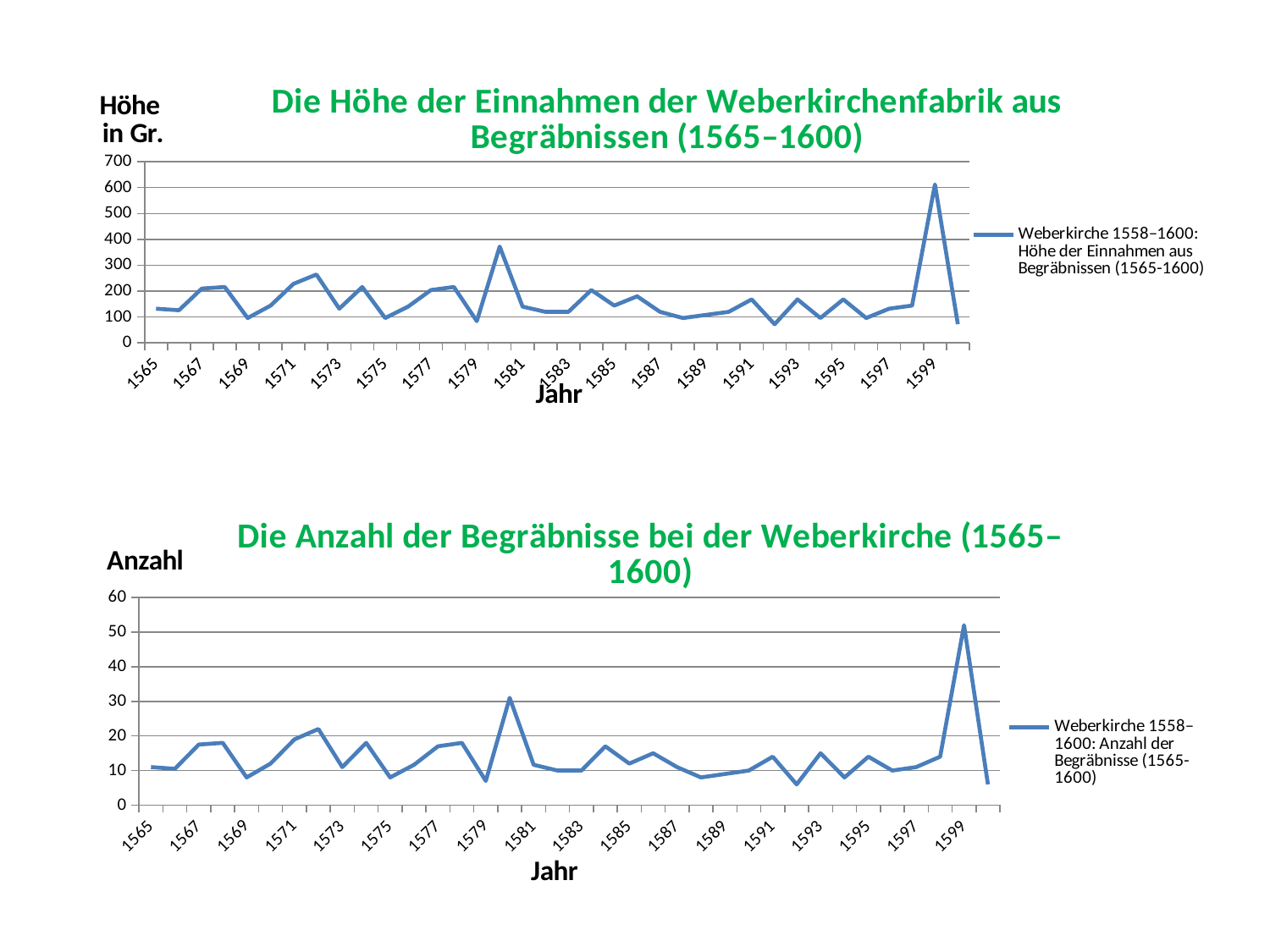
In the bottom chart (Anzahl der Begräbnisse), which year has the larger value, 1580 or 1572? 1580 In the top chart (Höhe der Einnahmen), is the value for 1580 greater or less than 300? greater In the top chart (Höhe der Einnahmen), in which year is the value highest? 1599 How many series does the legend of the bottom chart (Anzahl der Begräbnisse) list? 1 In the top chart (Höhe der Einnahmen), is the value for 1592 greater or less than 100? less What is the label of the x axis on the top chart (Höhe der Einnahmen)? Jahr In the bottom chart (Anzahl der Begräbnisse), in which year is the value highest? 1599 What kind of chart is the top chart, 'Die Höhe der Einnahmen der Weberkirchenfabrik aus Begräbnissen (1565–1600)'? line chart In the bottom chart (Anzahl der Begräbnisse), is the value for 1592 greater or less than 10? less In the top chart (Höhe der Einnahmen), which year has the larger value, 1580 or 1572? 1580